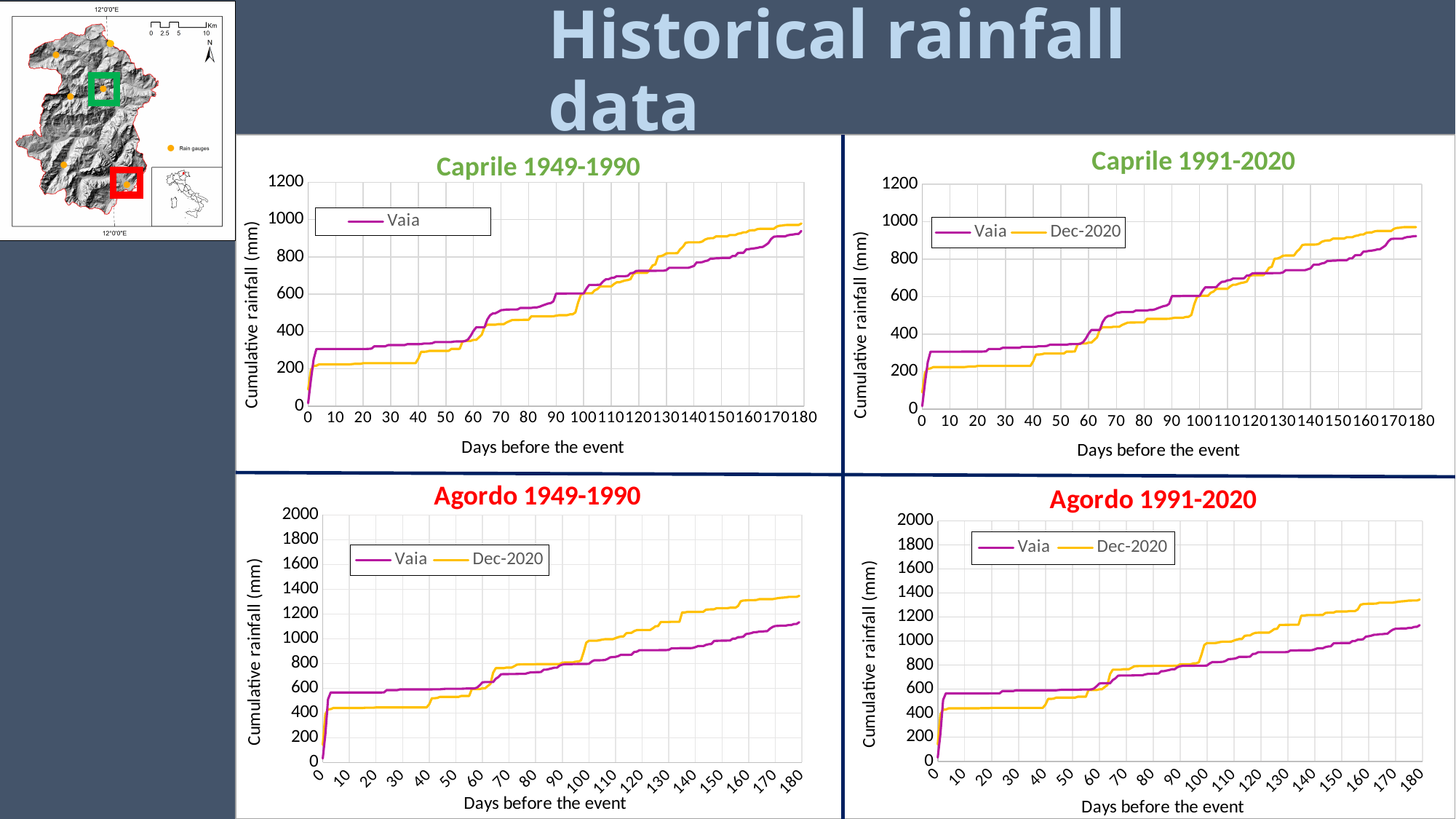
In the 'Agordo 1991-2020' chart, which series is higher at 180 days, Vaia or Dec-2020? Dec-2020 How many series does the legend of the 'Agordo 1949-1990' chart list? 2 In the 'Caprile 1949-1990' chart, which line is higher at 10 days before the event, the purple Vaia line or the yellow line? Vaia How many series does the legend of the 'Caprile 1949-1990' chart list? 1 In the 'Caprile 1991-2020' chart, is the Dec-2020 value at 40 days greater or less than 400? less In the 'Agordo 1949-1990' chart, is the Vaia value at 180 days greater or less than 1000? greater In the 'Agordo 1949-1990' chart, is the Dec-2020 value at 180 days greater or less than 1200? greater What is the x-axis label of the 'Caprile 1949-1990' chart? Days before the event In the 'Agordo 1991-2020' chart, does the Vaia line rise or fall as days before the event increase? rise What kind of chart is 'Caprile 1949-1990'? line chart What is the y-axis label of the 'Agordo 1991-2020' chart? Cumulative rainfall (mm)